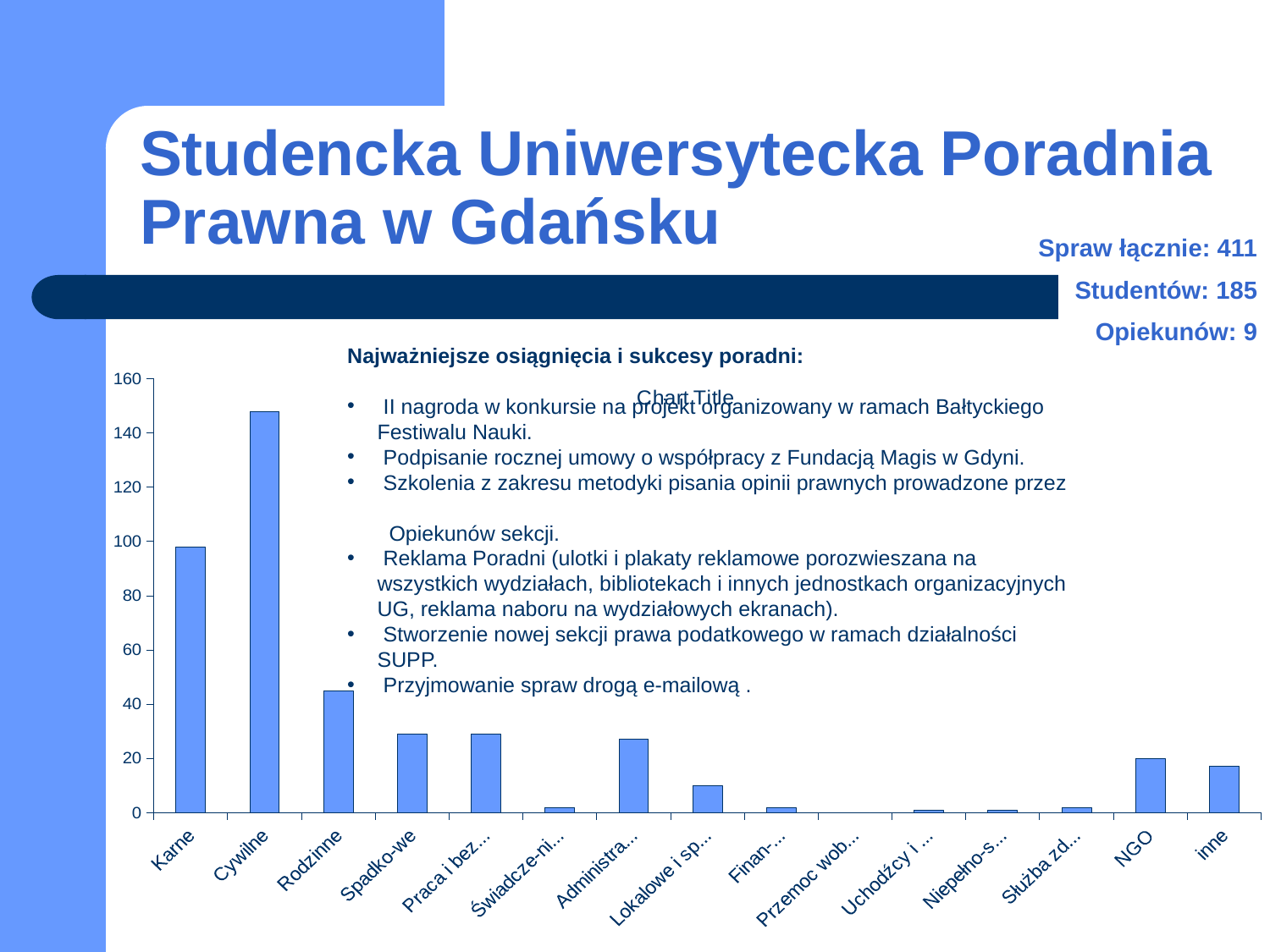
Which has a larger value, Karne or Rodzinne? Karne What kind of chart is shown on the slide? bar chart Which has a larger value, Rodzinne or NGO? Rodzinne Is the value for NGO greater or less than 40? less Which category has the highest value in the chart? Cywilne Is the value for Cywilne greater or less than 140? greater What is the title shown above the chart? Chart Title Is the value for Rodzinne greater or less than 60? less How many categories are shown on the x axis of the chart? 15 Which has a larger value, Karne or Cywilne? Cywilne